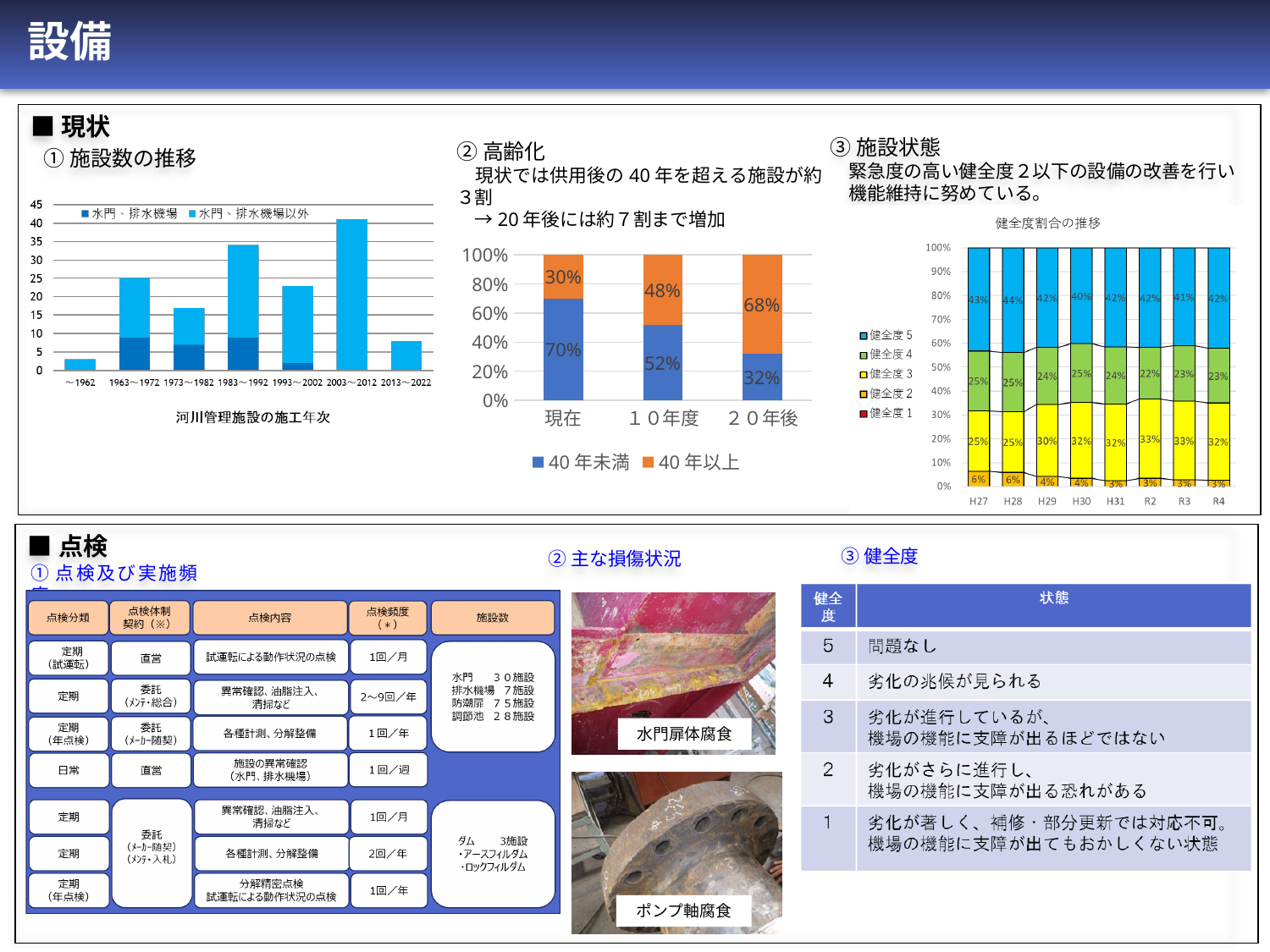
In the chart titled 河川管理施設の施工年次, which construction period has the shortest bar? ～1962 In the chart titled 健全度割合の推移, what is the 健全度3 share for R2? 33% In the 高齢化 chart (middle of the top row), does the 40年以上 share rise or fall from 現在 to 20年後? rise In the 高齢化 chart (middle of the top row), what is the difference between the 40年以上 share for 20年後 and for 現在? 38% In the chart titled 河川管理施設の施工年次, which construction period has the tallest bar? 2003～2012 In the chart titled 河川管理施設の施工年次, is the total bar for 1983～1992 greater or less than 30? greater In the chart titled 河川管理施設の施工年次, how many series does the legend list? 2 In the 高齢化 chart (middle of the top row), what percentage of facilities is 40年以上 for 現在? 30% In the 高齢化 chart (middle of the top row), what percentage of facilities is 40年未満 for 20年後? 32% In the chart titled 健全度割合の推移, how many series does the legend list? 5 In the chart titled 河川管理施設の施工年次, how many construction-period categories are shown on the x axis? 7